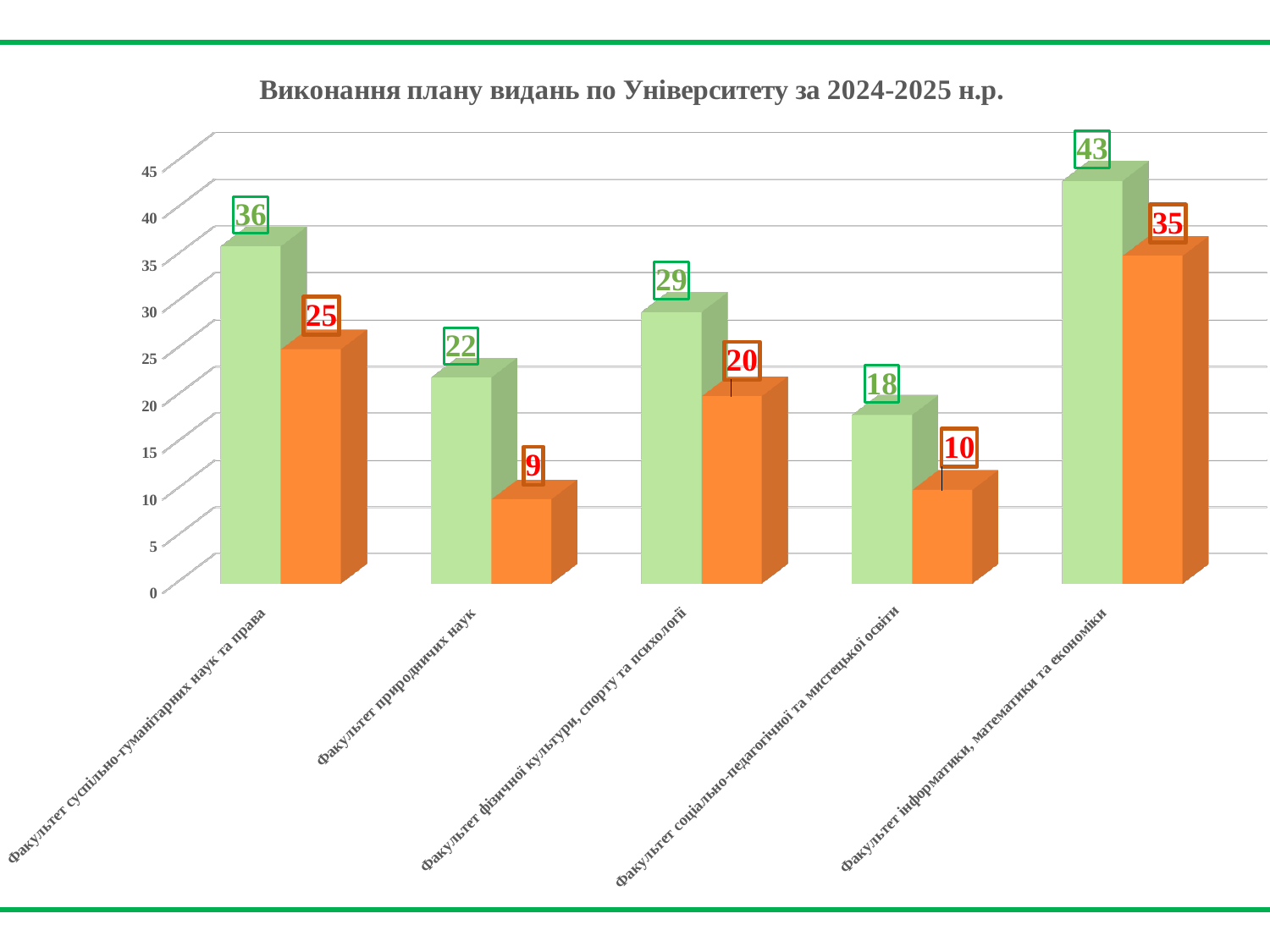
Is the green bar for Факультет соціально-педагогічної та мистецької освіти greater or less than 20? less What is the value of the orange bar for Факультет інформатики, математики та економіки? 35 How many faculties are shown on the x axis? 5 What is the value of the green bar for Факультет природничих наук? 22 Which faculty has the lowest orange bar? Факультет природничих наук Which faculty has the highest green bar? Факультет інформатики, математики та економіки Which is larger: the orange bar for Факультет фізичної культури, спорту та психології or the orange bar for Факультет соціально-педагогічної та мистецької освіти? Факультет фізичної культури, спорту та психології What kind of chart is shown on the slide? bar chart What is the title of the chart? Виконання плану видань по Університету за 2024-2025 н.р. What is the difference between the green and orange bars for Факультет суспільно-гуманітарних наук та права? 11 What is the value of the orange bar for Факультет соціально-педагогічної та мистецької освіти? 10 What is the difference between the green bars for Факультет інформатики, математики та економіки and Факультет фізичної культури, спорту та психології? 14